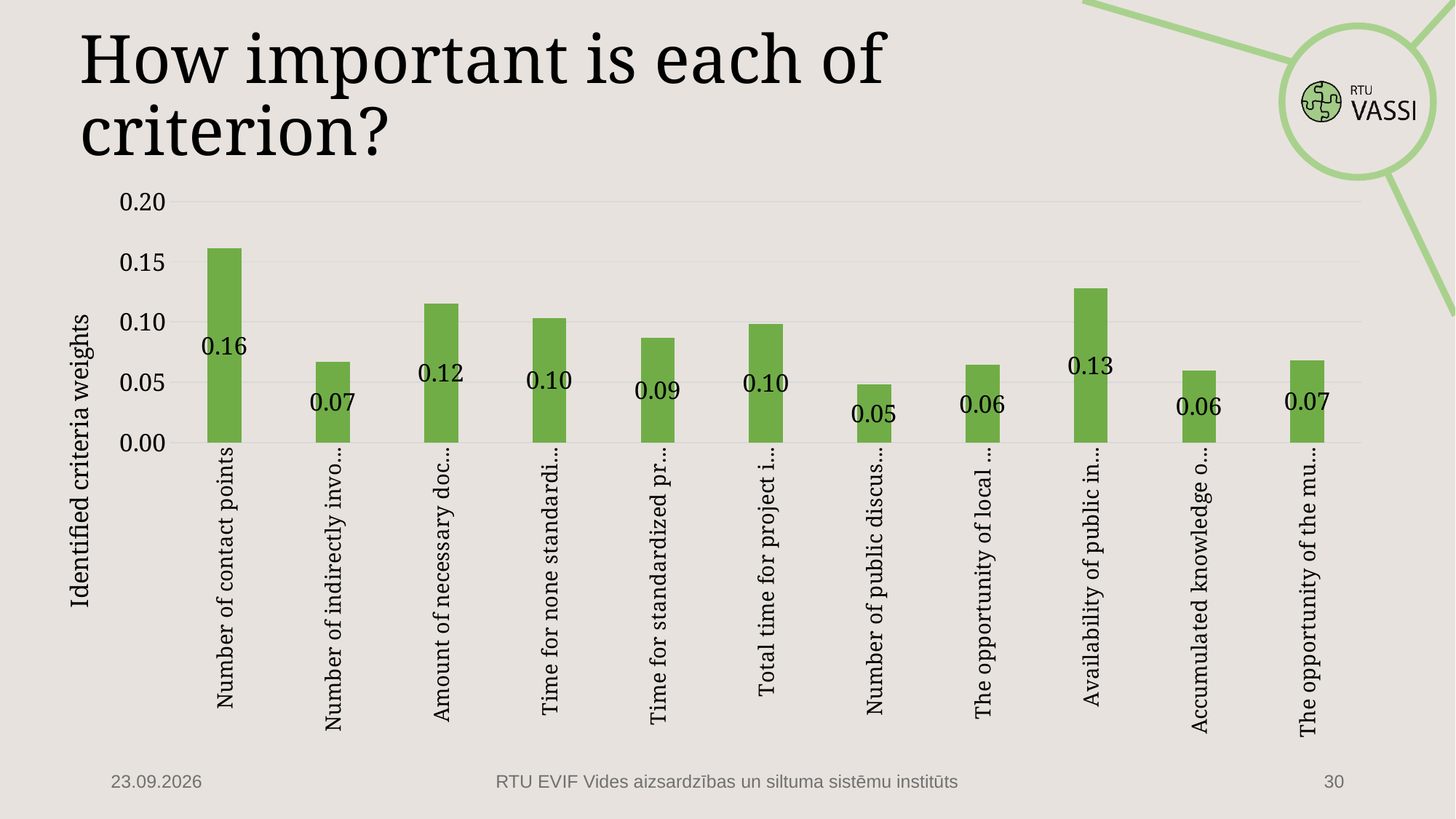
What is the value of the last bar on the right, labelled "The opportunity of the mu…"? 0.07 What is the title of the vertical axis? Identified criteria weights Which is larger: the bar labelled "Amount of necessary doc…" or the bar labelled "Availability of public in…"? Availability of public in… What is the lowest value shown on the chart? 0.05 How many bars are shown on the chart? 11 Is the value for "Number of contact points" greater or less than 0.15? greater What is the value for "Number of contact points"? 0.16 What is the value of the bar labelled "Time for standardized pr…" (fifth bar from the left)? 0.09 What is the difference between the value for "Number of contact points" and the value of the bar labelled "Availability of public in…"? 0.03 Which category has the highest identified criteria weight? Number of contact points What is the value of the bar labelled "Availability of public in…" (ninth bar from the left)? 0.13 What kind of chart is shown on the slide? bar chart